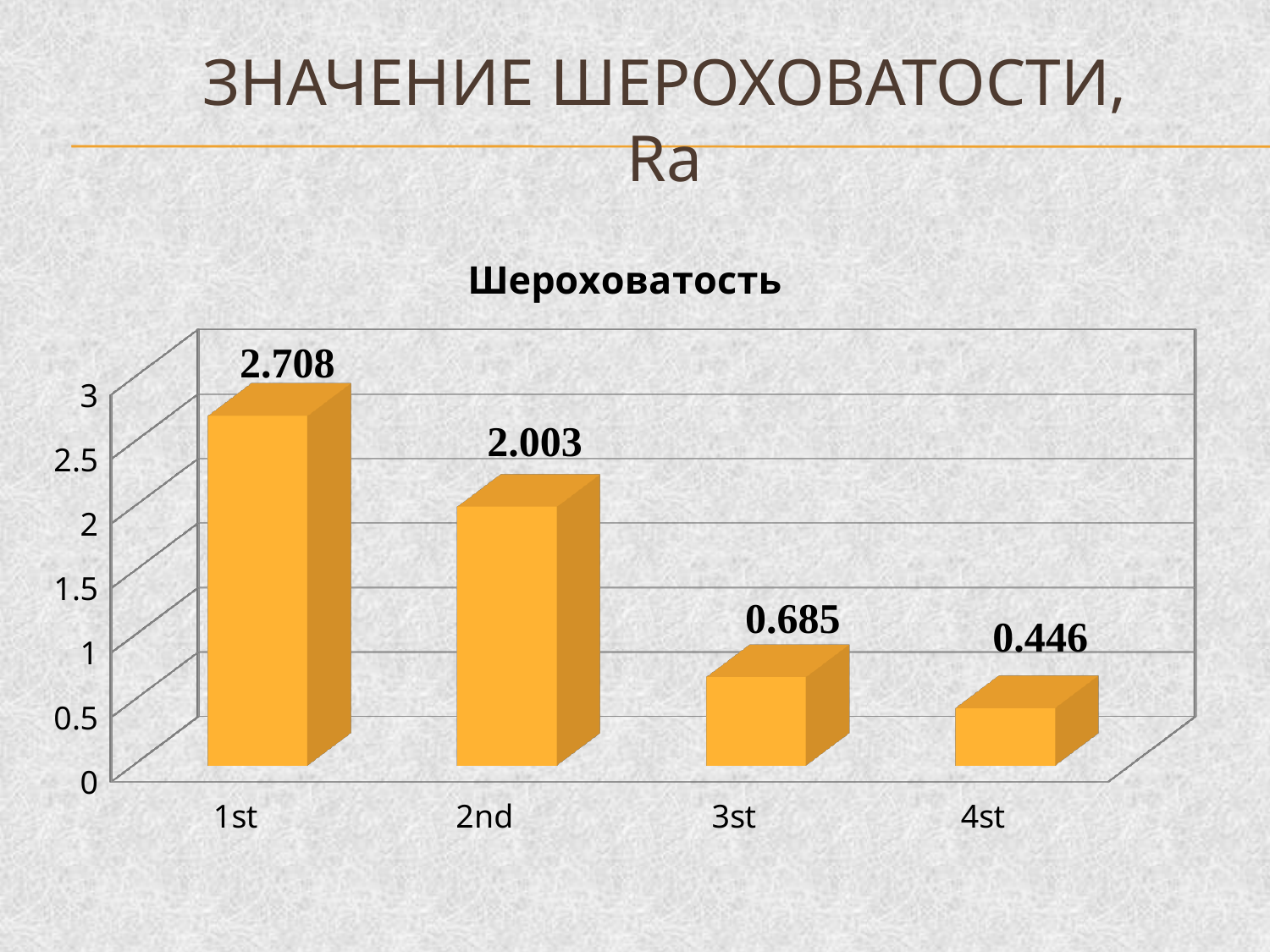
Do the values rise or fall from 1st to 4st? fall Which is larger, the value for 2nd or the value for 3st? 2nd Which category has the highest value? 1st What is the difference between the values for 3st and 4st? 0.239 What is the value for 2nd? 2.003 What is the value for 4st? 0.446 What is the difference between the values for 1st and 2nd? 0.705 What is the value for 1st? 2.708 What is the value for 3st? 0.685 Which category has the lowest value? 4st What kind of chart is this? bar chart How many categories are shown on the x axis? 4